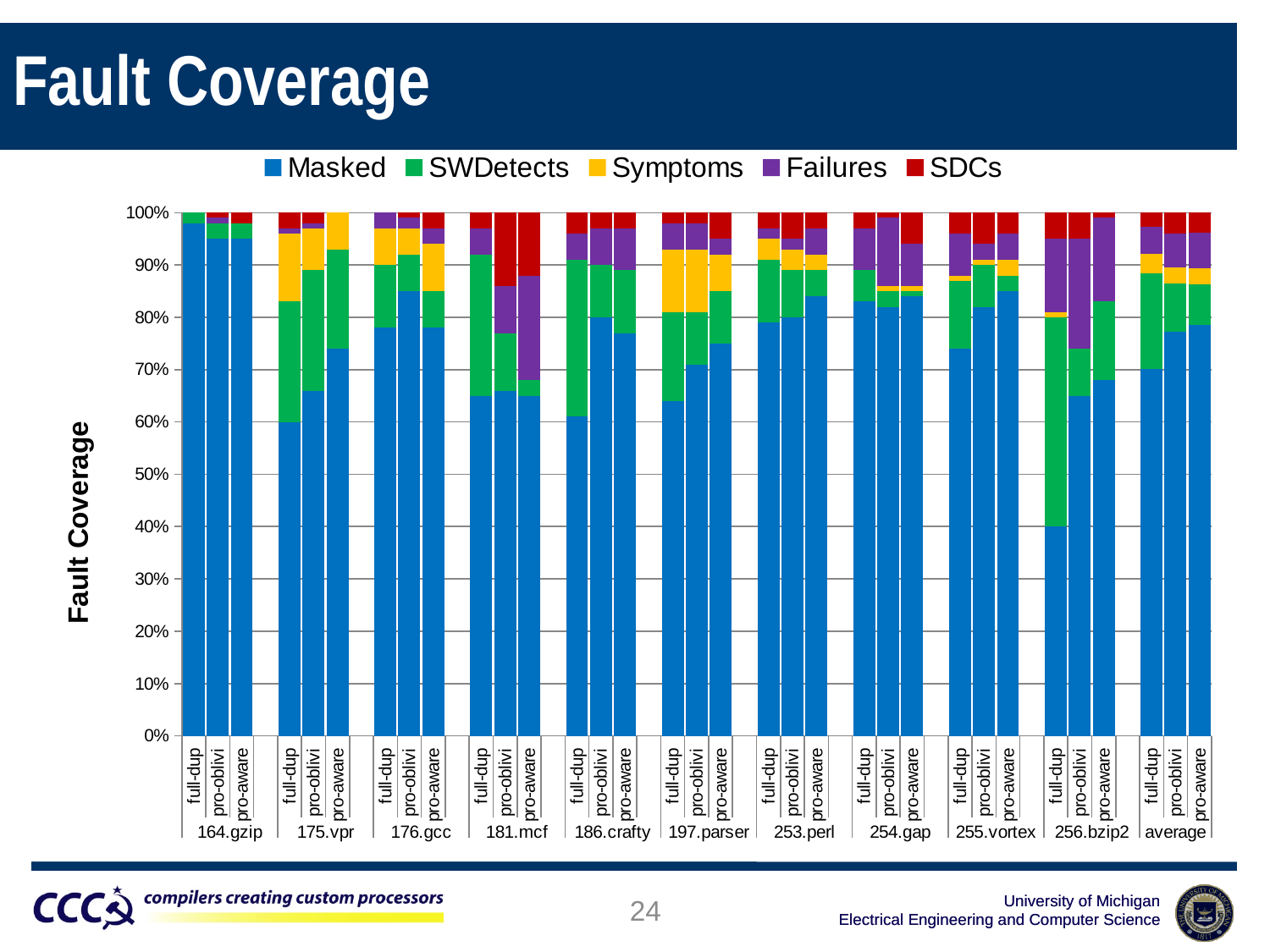
Is the Masked portion of the full-dup bar for 164.gzip greater or less than 90%? greater How many benchmark groups (including average) are shown along the x axis? 11 What is the label of the y axis? Fault Coverage Is the Masked portion of the pro-aware bar for 175.vpr greater or less than 70%? greater Which benchmark has the largest Masked portion in its full-dup bar? 164.gzip How many bars are shown for each benchmark group? 3 What kind of chart is shown on the slide? stacked bar chart Which series are listed in the legend? Masked, SWDetects, Symptoms, Failures, SDCs How many series does the legend list? 5 Which has a larger Masked portion: the full-dup bar for 164.gzip or the full-dup bar for 181.mcf? 164.gzip full-dup Which benchmark has the smallest Masked portion in its full-dup bar? 256.bzip2 Is the Masked portion of the full-dup bar for 256.bzip2 greater or less than 50%? less